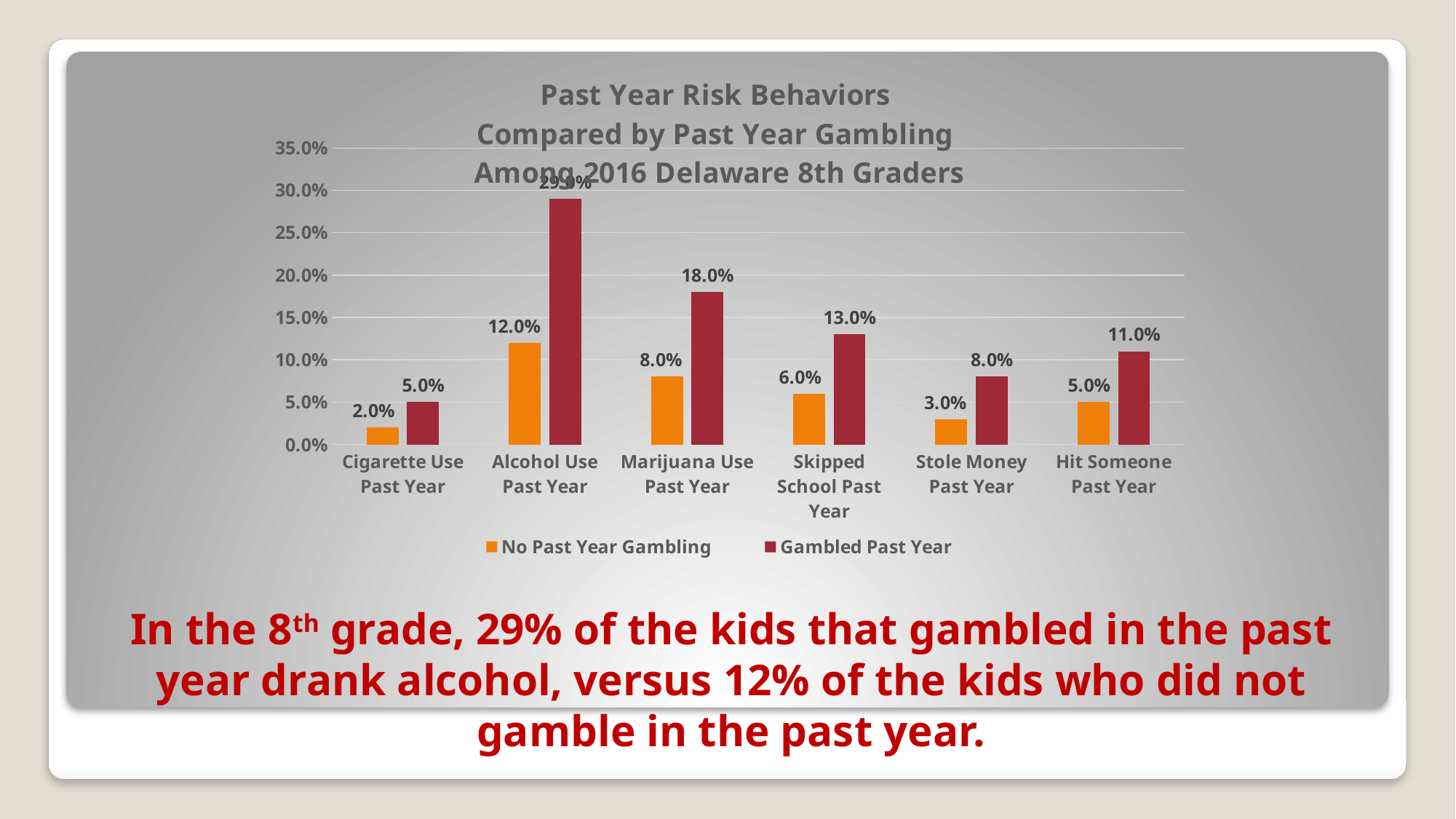
How many series does the legend list? 2 Which category has the highest value for the Gambled Past Year series? Alcohol Use Past Year What is the value for Cigarette Use Past Year among those with No Past Year Gambling? 2.0% Which is larger for Stole Money Past Year: the No Past Year Gambling value or the Gambled Past Year value? Gambled Past Year How many risk behavior categories are shown on the x axis? 6 What is the value for Marijuana Use Past Year among those who Gambled Past Year? 18.0% Which category has the lowest value for the No Past Year Gambling series? Cigarette Use Past Year What is the value for Hit Someone Past Year among those with No Past Year Gambling? 5.0% What is the difference between the Gambled Past Year and No Past Year Gambling values for Marijuana Use Past Year? 10.0% Which series is shown in orange in the legend? No Past Year Gambling What type of chart is shown on the slide? Bar chart What is the value for Skipped School Past Year among those who Gambled Past Year? 13.0%